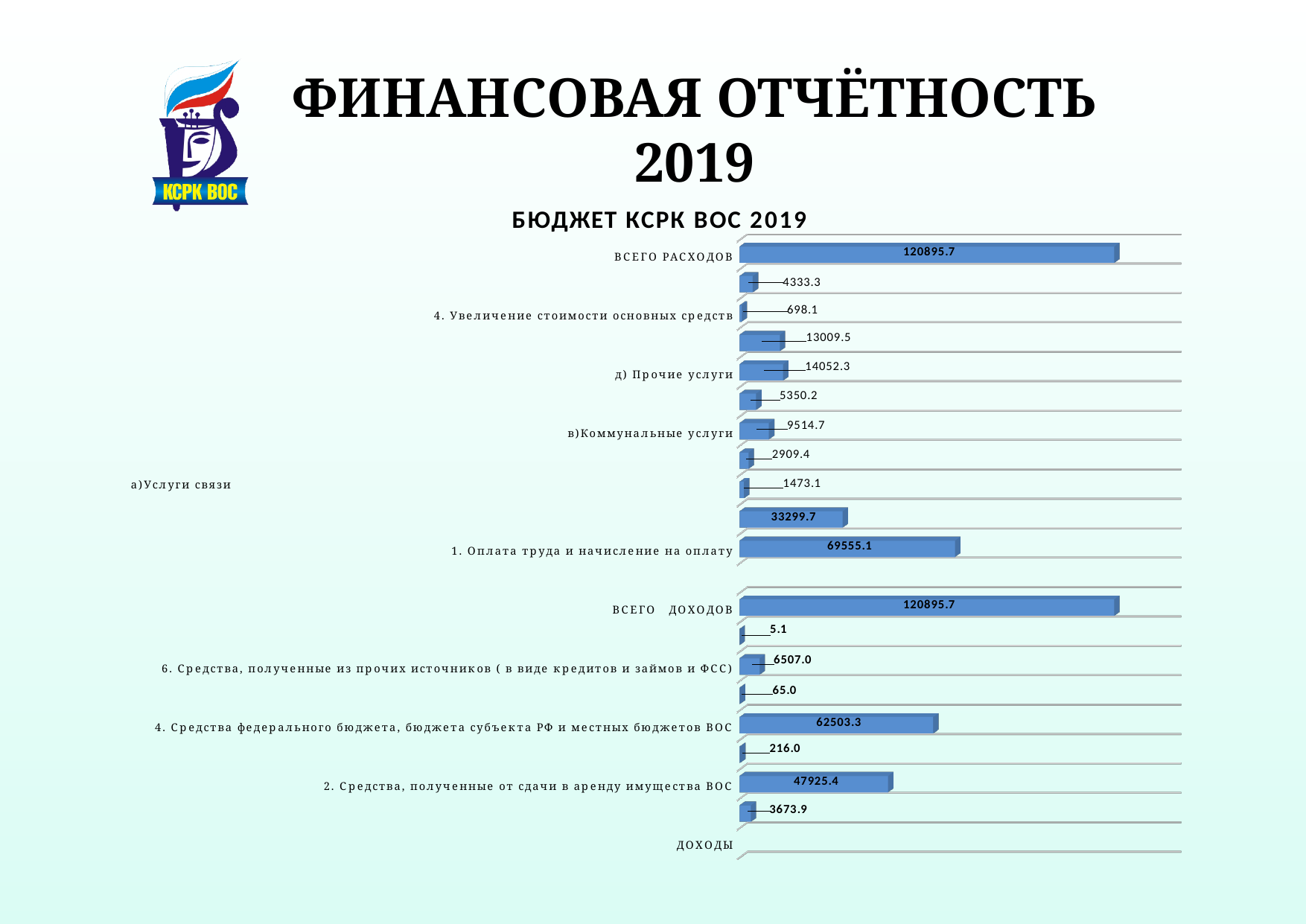
What is the value for 6. Средства, полученные из прочих источников ( в виде кредитов и займов и ФСС)? 6507.0 What is the difference between the values for д) Прочие услуги and в)Коммунальные услуги? 4537.6 What is the value for 4. Средства федерального бюджета, бюджета субъекта РФ и местных бюджетов ВОС? 62503.3 What is the value for ВСЕГО РАСХОДОВ? 120895.7 Which is larger: 4. Средства федерального бюджета, бюджета субъекта РФ и местных бюджетов ВОС or 2. Средства, полученные от сдачи в аренду имущества ВОС? 4. Средства федерального бюджета, бюджета субъекта РФ и местных бюджетов ВОС What is the value for д) Прочие услуги? 14052.3 What is the title of the chart? БЮДЖЕТ КСРК ВОС 2019 What is the value for 1. Оплата труда и начисление на оплату? 69555.1 What kind of chart is shown on the slide? Bar chart What is the value for 2. Средства, полученные от сдачи в аренду имущества ВОС? 47925.4 What is the value for в)Коммунальные услуги? 9514.7 What is the value for а)Услуги связи? 1473.1